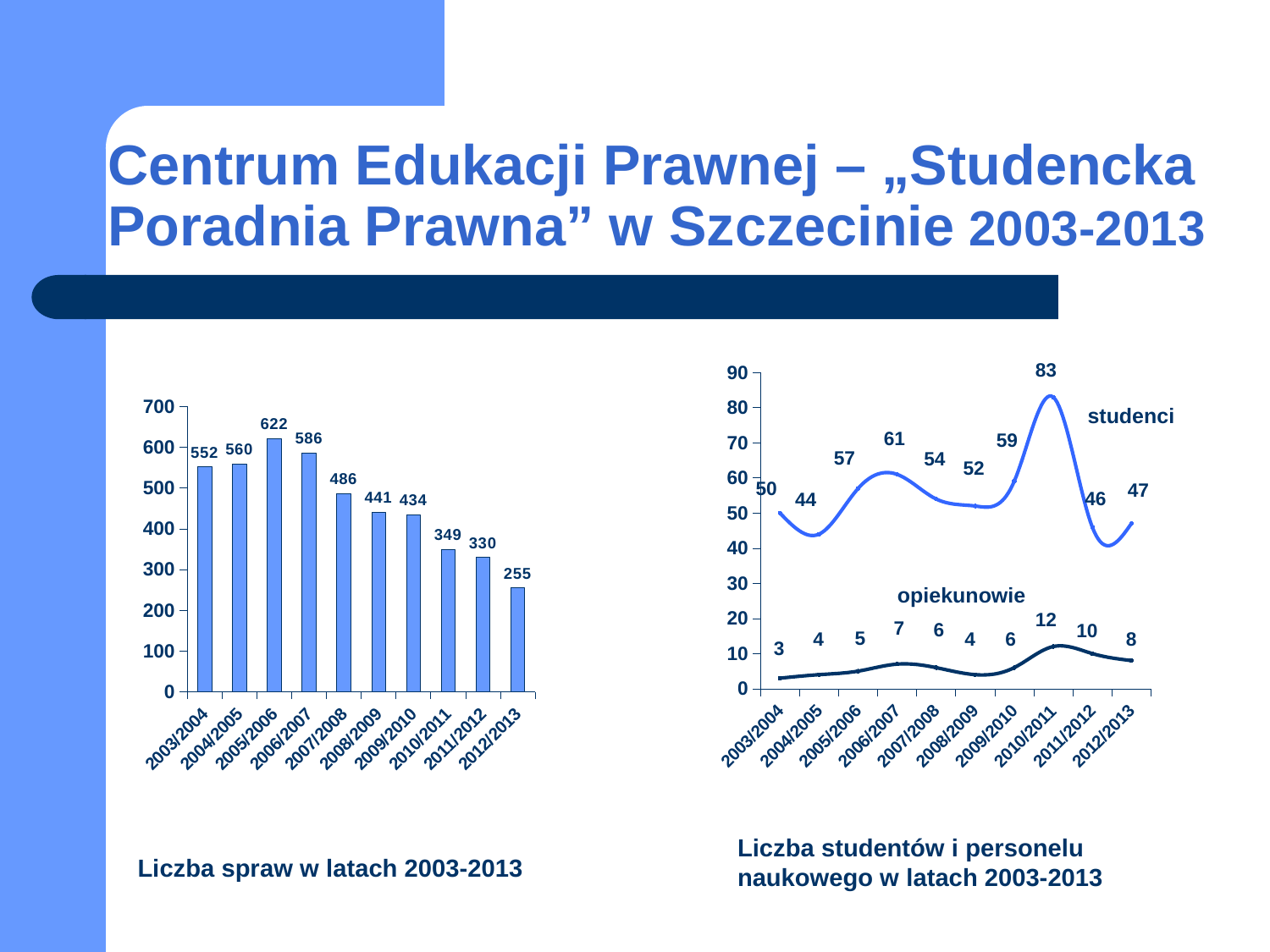
What kind of chart is 'Liczba studentów i personelu naukowego w latach 2003-2013'? line chart What kind of chart is 'Liczba spraw w latach 2003-2013'? bar chart In the chart 'Liczba spraw w latach 2003-2013', how many years are shown on the x axis? 10 In the chart 'Liczba studentów i personelu naukowego w latach 2003-2013', what is the value for opiekunowie in 2006/2007? 7 In the chart 'Liczba studentów i personelu naukowego w latach 2003-2013', which is larger for studenci: 2004/2005 or 2005/2006? 2005/2006 In the chart 'Liczba spraw w latach 2003-2013', what is the difference between the values for 2003/2004 and 2012/2013? 297 In the chart 'Liczba spraw w latach 2003-2013', which year has the lowest value? 2012/2013 In the chart 'Liczba studentów i personelu naukowego w latach 2003-2013', what is the value for studenci in 2010/2011? 83 In the chart 'Liczba spraw w latach 2003-2013', what is the value for 2005/2006? 622 In the chart 'Liczba spraw w latach 2003-2013', do the values generally rise or fall from 2006/2007 to 2012/2013? fall In the chart 'Liczba studentów i personelu naukowego w latach 2003-2013', what is the difference between studenci and opiekunowie in 2012/2013? 39 In the chart 'Liczba studentów i personelu naukowego w latach 2003-2013', which year has the highest value for opiekunowie? 2010/2011